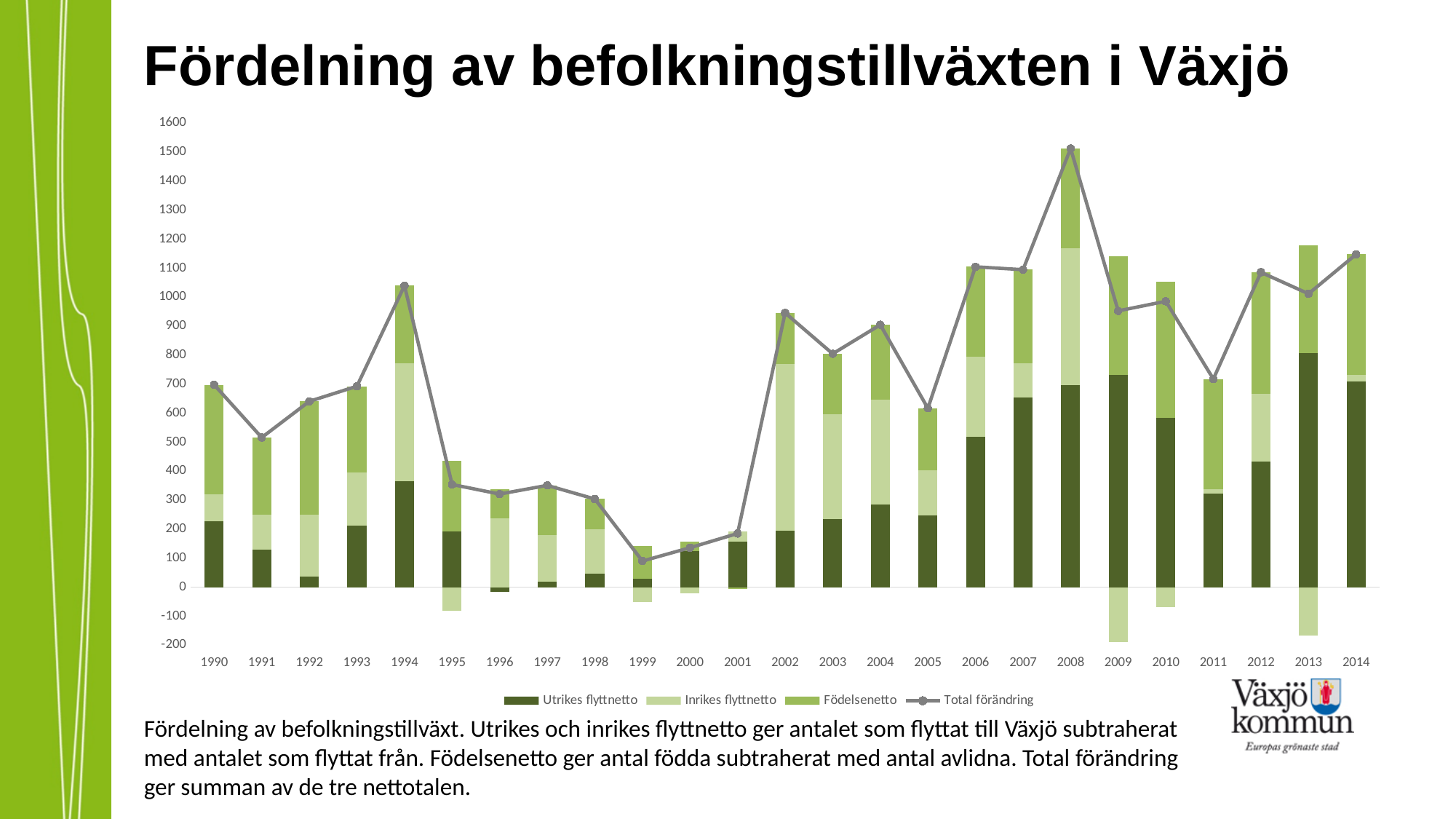
How many years are shown on the x axis? 25 How many series does the legend list? 4 What kind of chart is shown on the slide? A stacked bar chart combined with a line Which year has the larger Total förändring, 1990 or 1991? 1990 Which series is drawn as a line with markers? Total förändring Is the Total förändring value for 1999 greater or less than 200? less In which year is Total förändring highest? 2008 Which year has the larger Total förändring, 2005 or 2006? 2006 Is the Total förändring value for 2011 greater or less than 600? greater Is the Total förändring value for 2008 greater or less than 1400? greater In which year is Total förändring lowest? 1999 Does Total förändring rise or fall from 1994 to 1999? fall